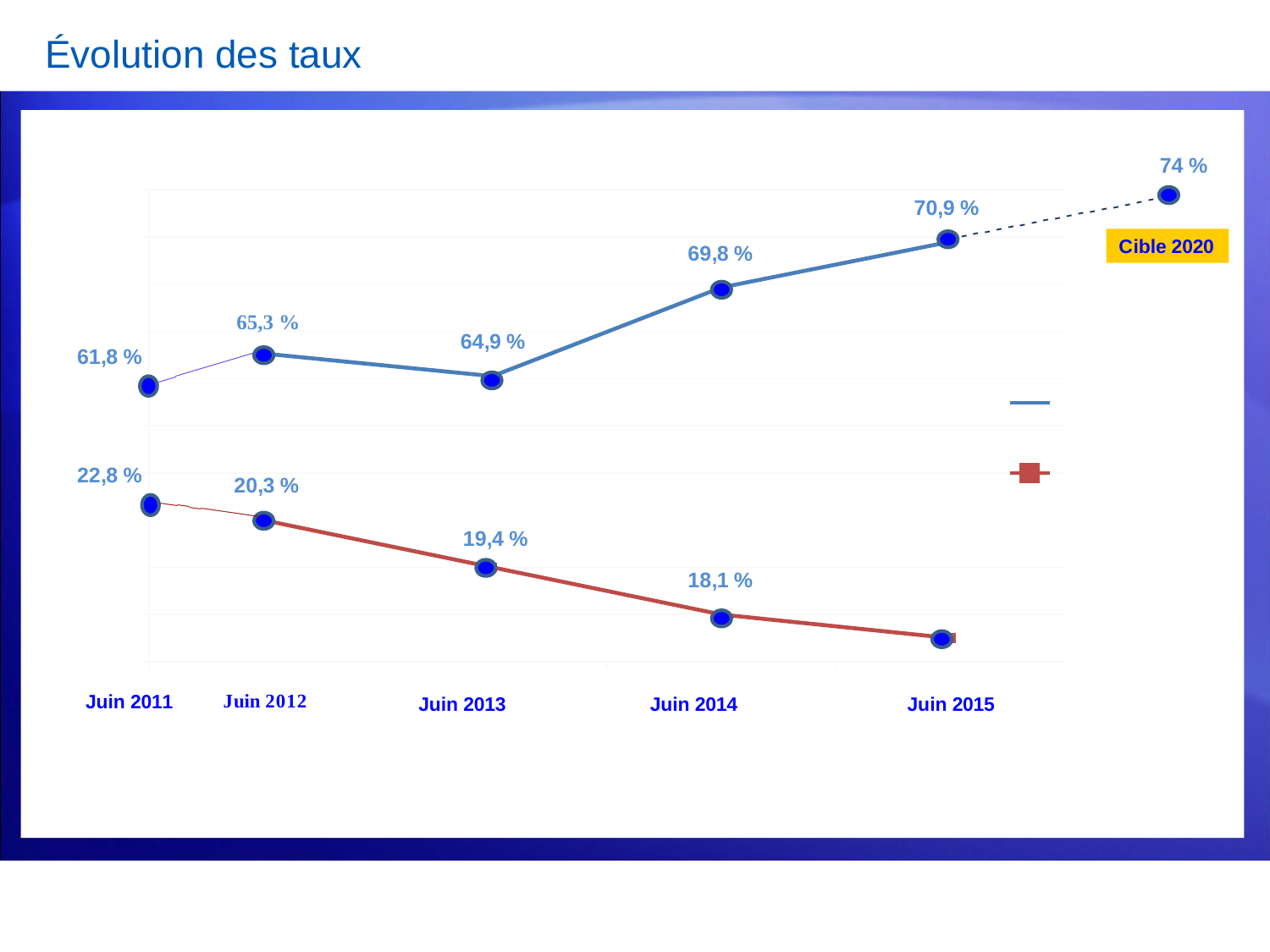
Which is larger for the upper blue line: the value in Juin 2012 or in Juin 2013? Juin 2012 How many dates are labelled on the x axis? 5 What is the difference between the upper blue line's values in Juin 2015 and Juin 2011? 9,1 % What is the value of the upper blue line in Juin 2011? 61,8 % What value is shown for the Cible 2020 point? 74 % What is the difference between the lower red line's values in Juin 2011 and Juin 2014? 4,7 % What is the value of the upper blue line in Juin 2015? 70,9 % What kind of chart is shown on the slide? Line chart In which year does the upper blue line reach its highest labelled value between Juin 2011 and Juin 2015? Juin 2015 In which year does the lower red line have its highest value? Juin 2011 Does the lower red line rise or fall from Juin 2011 to Juin 2015? Fall What is the value of the lower red line in Juin 2013? 19,4 %